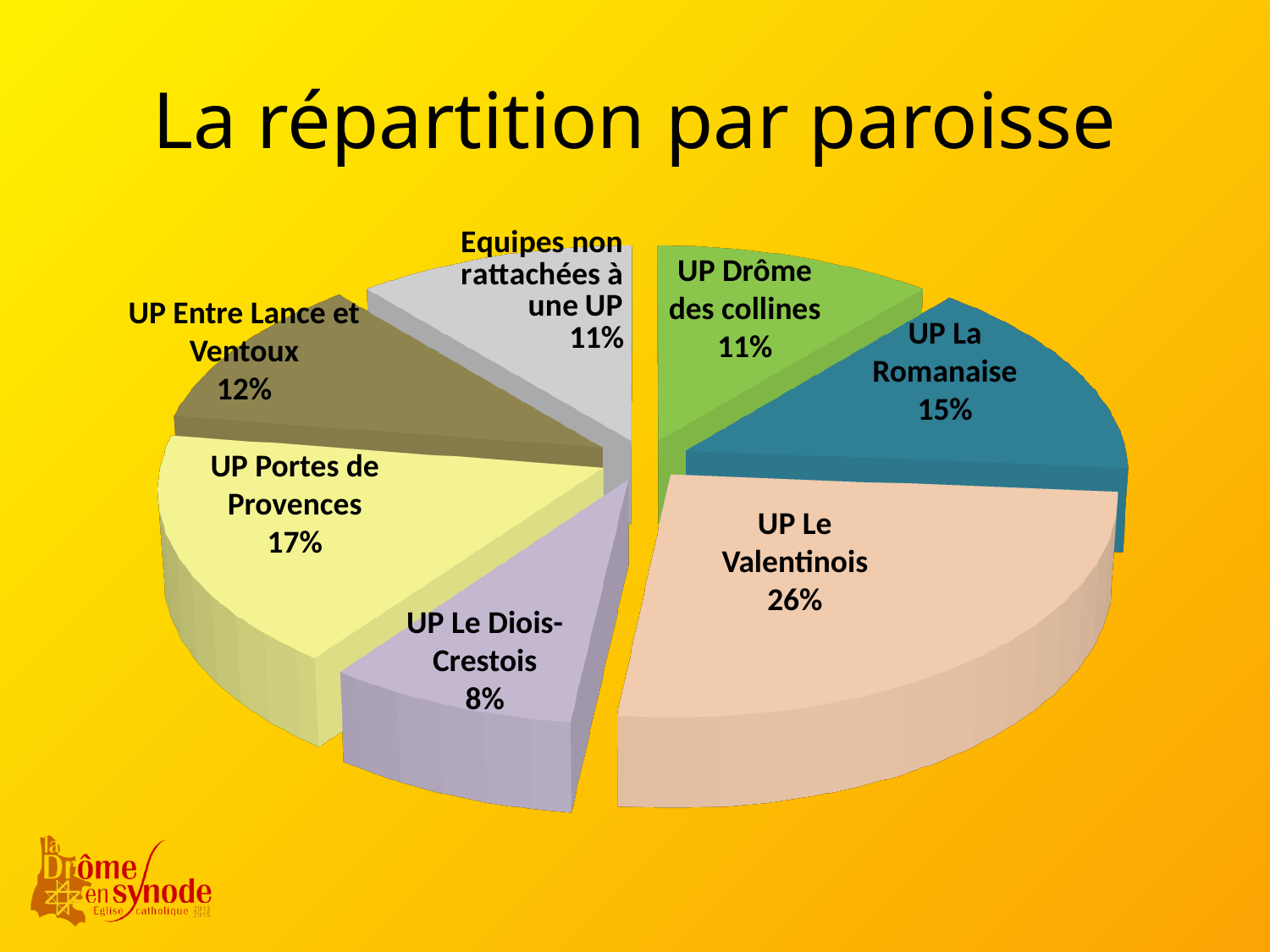
Which is larger, UP Entre Lance et Ventoux or UP La Romanaise? UP La Romanaise What share is labelled for Equipes non rattachées à une UP? 11% What is the difference in percentage points between UP Le Valentinois and UP Portes de Provences? 9 How many slices does the pie chart have? 7 What kind of chart is shown on the slide? Pie chart What is the title of the slide? La répartition par paroisse What share of the pie does UP Le Valentinois have? 26% Which slice of the pie is the largest? UP Le Valentinois Which slice of the pie is the smallest? UP Le Diois-Crestois What is the combined share of UP Drôme des collines and UP La Romanaise? 26% What percentage is shown for UP Portes de Provences? 17% What percentage is shown for UP La Romanaise? 15%